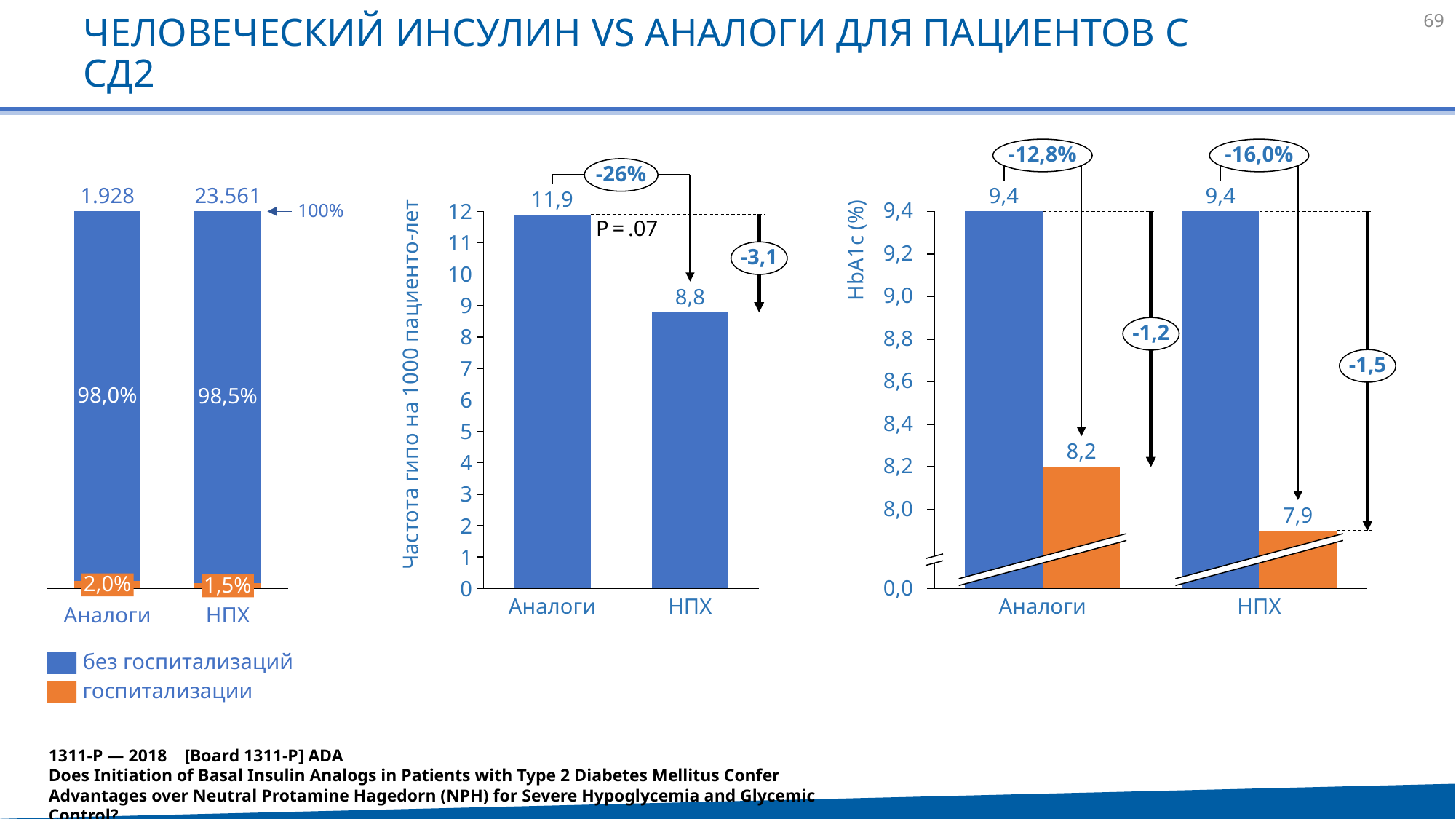
In the left chart, what is the total number of patients shown above the НПХ bar? 23.561 In the left chart, what percentage of the НПХ group had hospitalizations (госпитализации)? 1,5% In the right chart, what is the difference between the blue and orange bars for the Аналоги group? 1,2 In the middle chart, which group has the higher hypoglycemia frequency, Аналоги or НПХ? Аналоги In the middle chart, what is the hypoglycemia frequency per 1000 patient-years for НПХ? 8,8 In the right chart, what is the HbA1c (%) value for the orange bar in the НПХ group? 7,9 In the left chart, how many series does the legend list? 2 In the middle chart, what is the hypoglycemia frequency per 1000 patient-years for Аналоги? 11,9 In the middle chart, what is the difference between the Аналоги and НПХ values? 3,1 In the left chart, what percentage of the Аналоги group had no hospitalizations (без госпитализаций)? 98,0% What type of chart is the right chart (HbA1c)? Bar chart In the middle chart, what P value is shown? P = .07